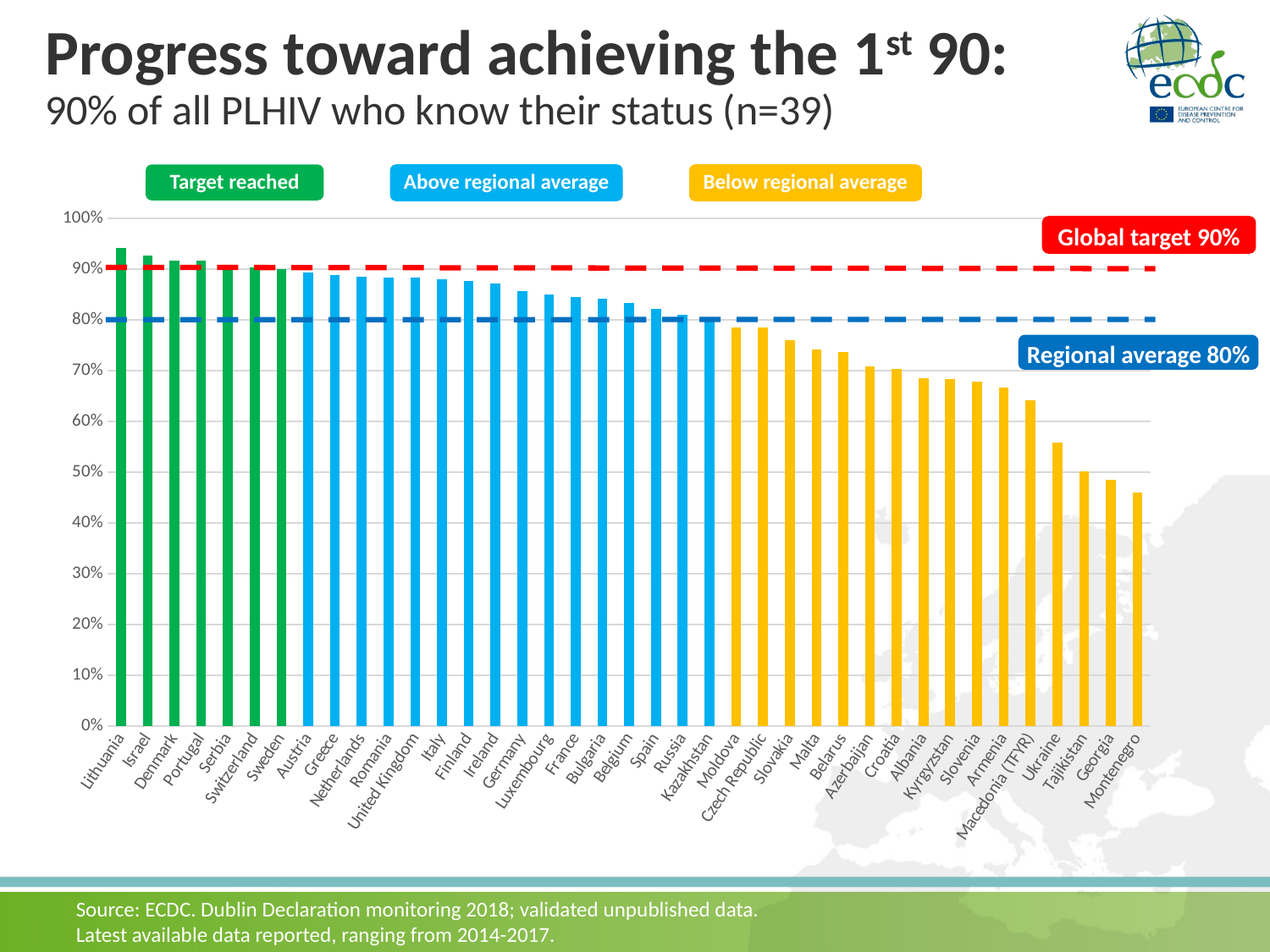
Which has a larger value, Israel or Spain? Israel What value does the red dashed line labelled 'Global target' represent? 90% Is the value for Moldova greater or less than 80%? less Which country has the lowest value in the chart? Montenegro Is the value for Malta greater or less than 70%? greater How many countries are plotted in the chart? 39 Is the value for Montenegro greater or less than 50%? less How many categories does the colour legend above the chart list? 3 What type of chart is shown on the slide? Bar chart Which country has the highest value in the chart? Lithuania Do the values rise or fall moving from left to right along the x axis? Fall